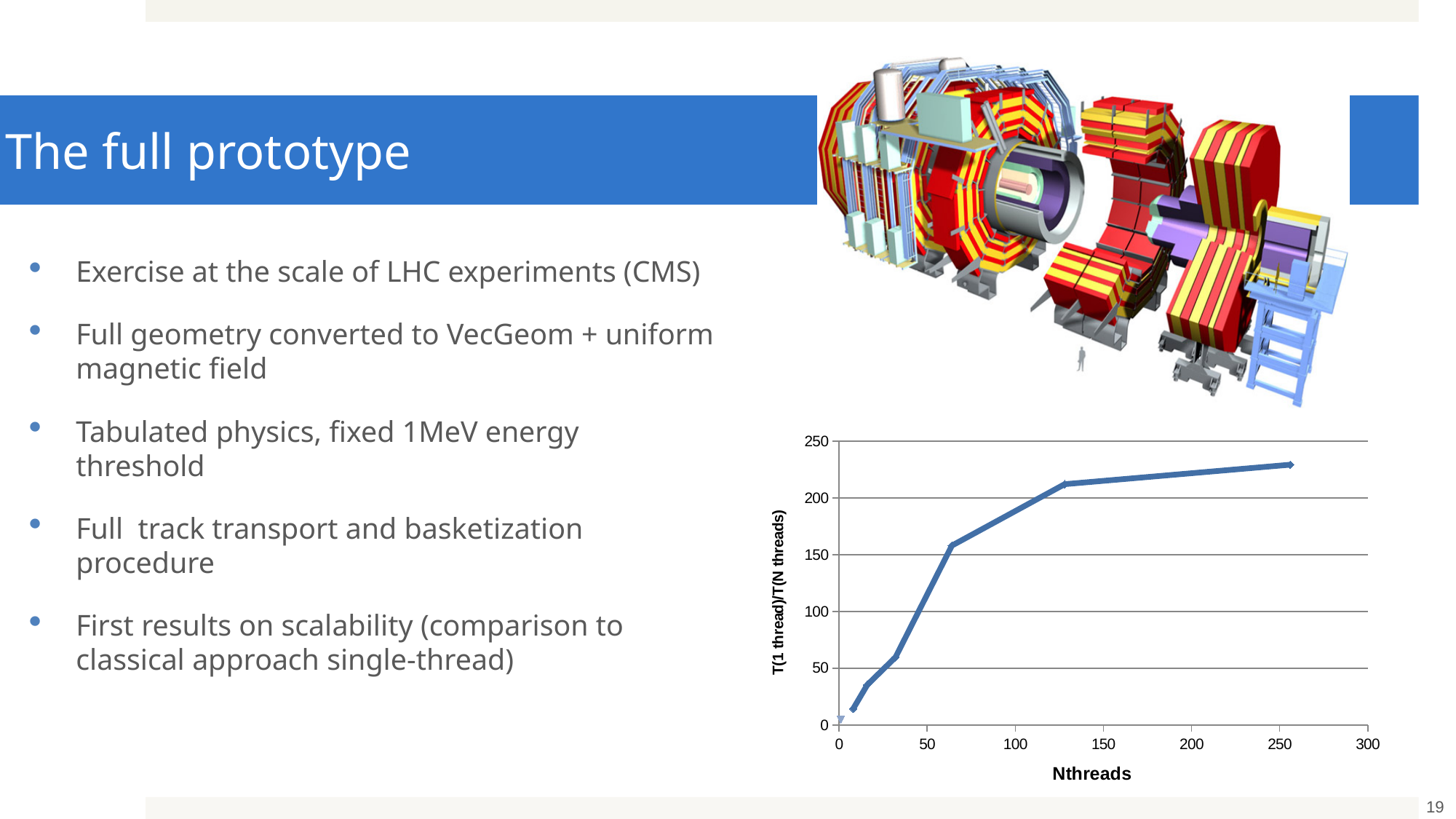
Is the value at about 125 threads greater or less than 200? greater What is the label of the x axis of the chart? Nthreads What kind of chart is shown on the slide? line chart Is the value at about 65 threads greater or less than 150? greater Do the values rise or fall as Nthreads increases along the x axis? rise Is the value at about 65 threads greater or less than 200? less What is the highest tick value shown on the x axis? 300 What is the label of the y axis of the chart? T(1 thread)/T(N threads)